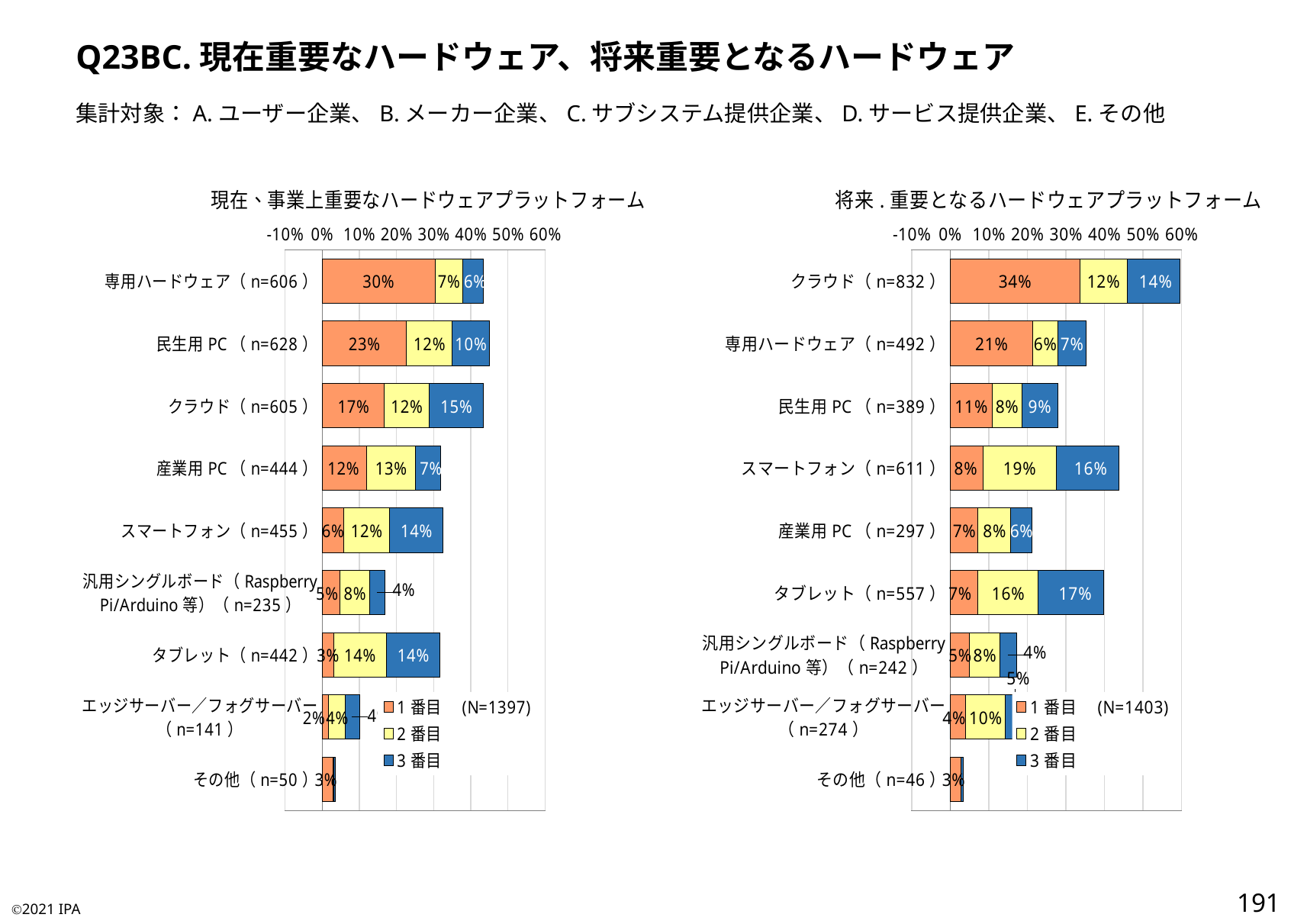
What is the N value shown next to the legend of the right chart? N=1403 In the left chart (現在、事業上重要なハードウェアプラットフォーム), what is the 1番目 value for 専用ハードウェア? 30% In the left chart (現在、事業上重要なハードウェアプラットフォーム), which category has the highest 3番目 value? クラウド In the right chart (将来．重要となるハードウェアプラットフォーム), what is the 3番目 value for タブレット? 17% In the right chart (将来．重要となるハードウェアプラットフォーム), which category has the highest 1番目 value? クラウド In the right chart (将来．重要となるハードウェアプラットフォーム), which is larger: the 2番目 value for スマートフォン or the 2番目 value for タブレット? スマートフォン In the left chart (現在、事業上重要なハードウェアプラットフォーム), what is the difference between the 1番目 values for 専用ハードウェア and 民生用PC? 7% What kind of chart is the left chart (現在、事業上重要なハードウェアプラットフォーム)? Stacked bar chart In the right chart (将来．重要となるハードウェアプラットフォーム), what is the total of the stacked bar for クラウド? 60% How many categories are plotted in the right chart (将来．重要となるハードウェアプラットフォーム)? 9 In the left chart (現在、事業上重要なハードウェアプラットフォーム), what is the 2番目 value for タブレット? 14% How many series does the legend of the left chart list? 3